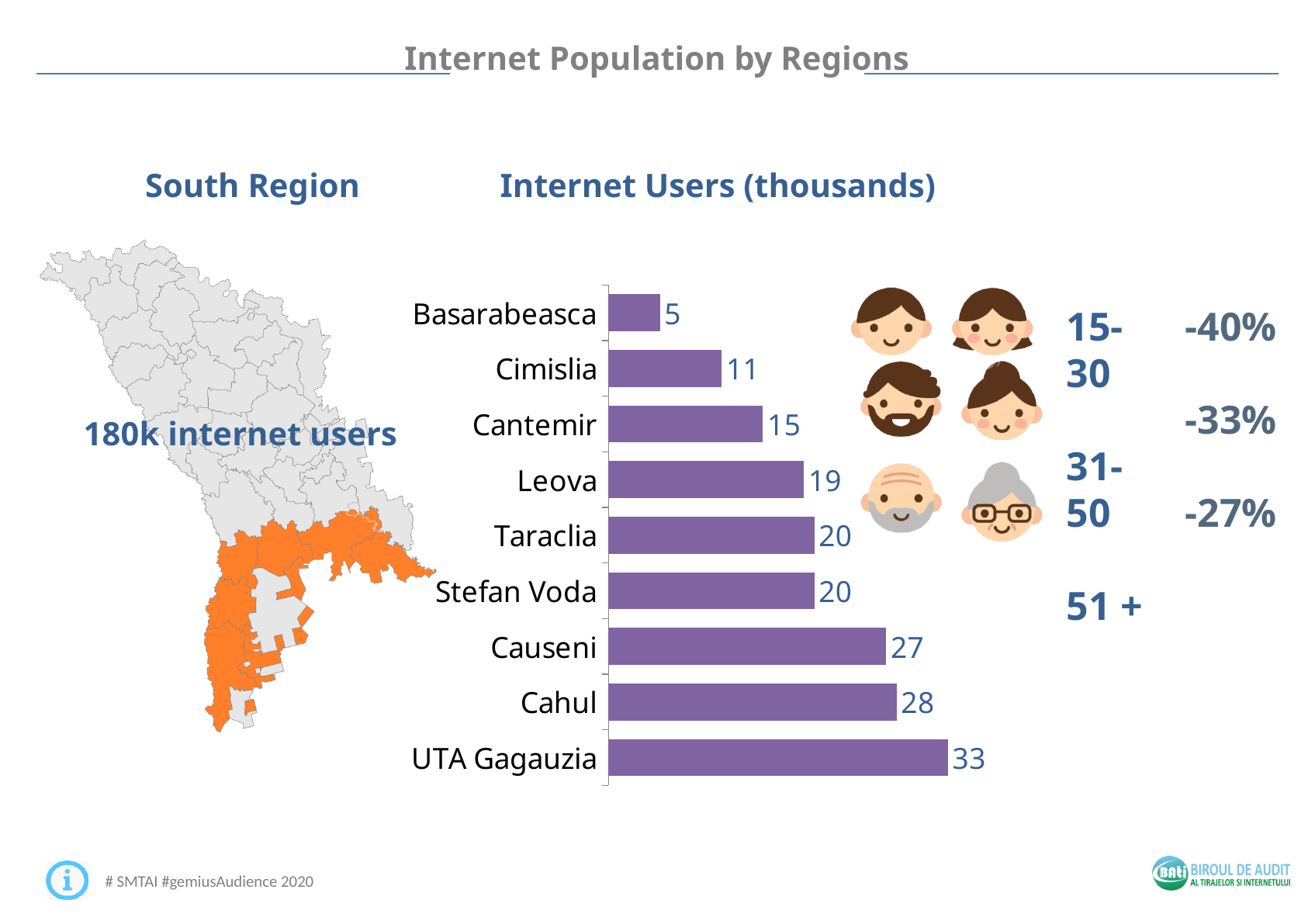
What is the value for Cahul in the Internet Users (thousands) chart? 28 Which two regions share the same value of 20 in the chart? Taraclia and Stefan Voda Which has a larger value, Cahul or Taraclia? Cahul How many regions are shown in the Internet Users (thousands) chart? 9 What is the title of the chart on the slide? Internet Users (thousands) Which region has the lowest number of internet users in the chart? Basarabeasca What is the difference between the values for UTA Gagauzia and Cimislia? 22 What is the value for Leova in the Internet Users (thousands) chart? 19 What is the value for Basarabeasca in the Internet Users (thousands) chart? 5 What is the difference between the values for Causeni and Cantemir? 12 What kind of chart is used to show Internet Users (thousands)? Bar chart Which region has the highest number of internet users in the chart? UTA Gagauzia